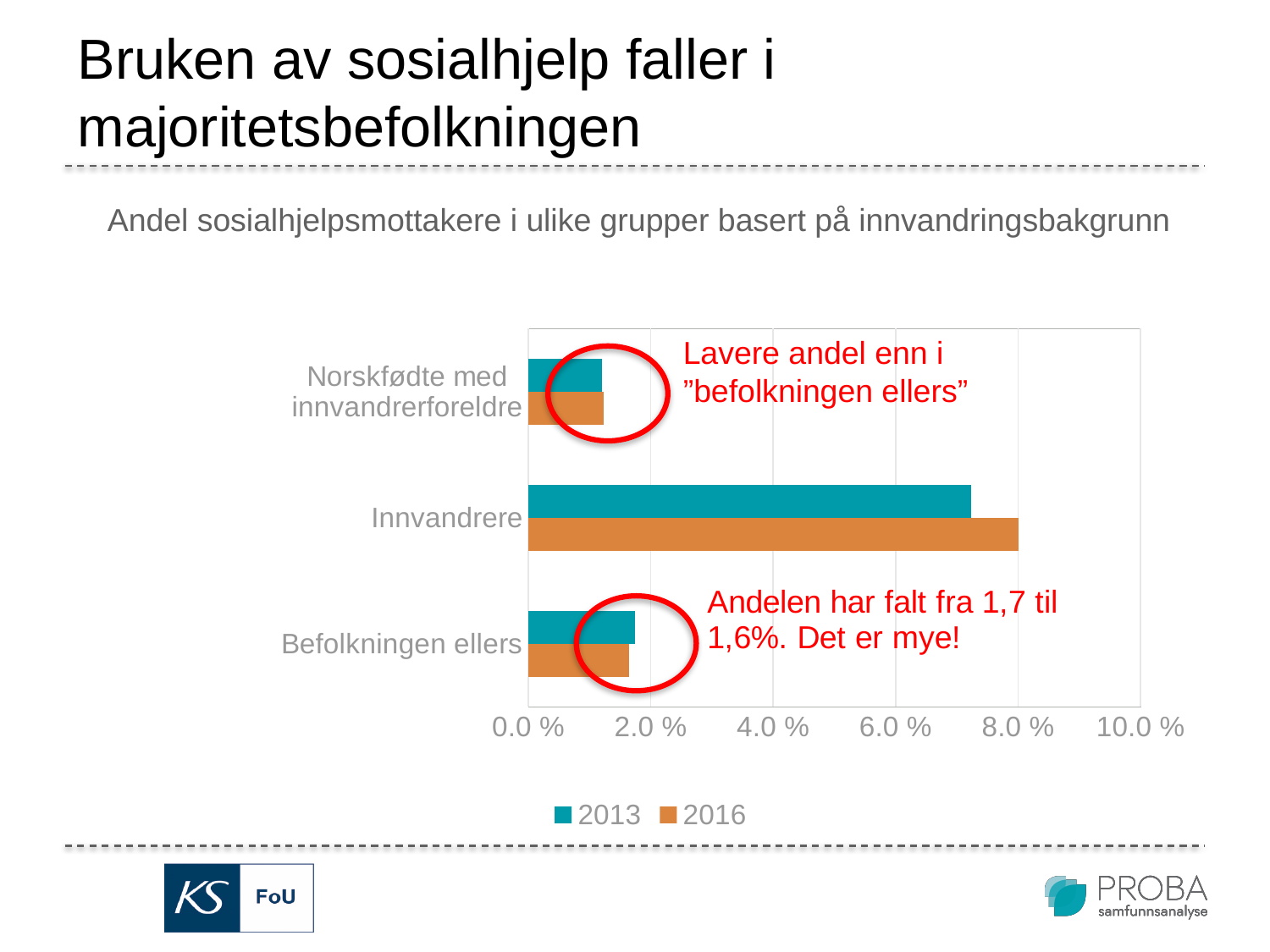
Which group has the highest share of social assistance recipients in 2016? Innvandrere Which years are listed in the chart legend? 2013 and 2016 Is the 2013 value for Norskfødte med innvandrerforeldre greater or less than 2.0 %? less Did the share for Befolkningen ellers rise or fall from 2013 to 2016? fall Is the 2013 value for Innvandrere greater or less than 6.0 %? greater Which group has the lowest share of social assistance recipients in 2013? Norskfødte med innvandrerforeldre How many series does the legend list? 2 What kind of chart is shown on the slide? bar chart Is the 2016 value for Befolkningen ellers greater or less than 4.0 %? less How many categories (groups) are shown on the chart? 3 According to the annotation on the slide, what is the share for Befolkningen ellers in 2016? 1,6% For Innvandrere, which year has the larger value, 2013 or 2016? 2016